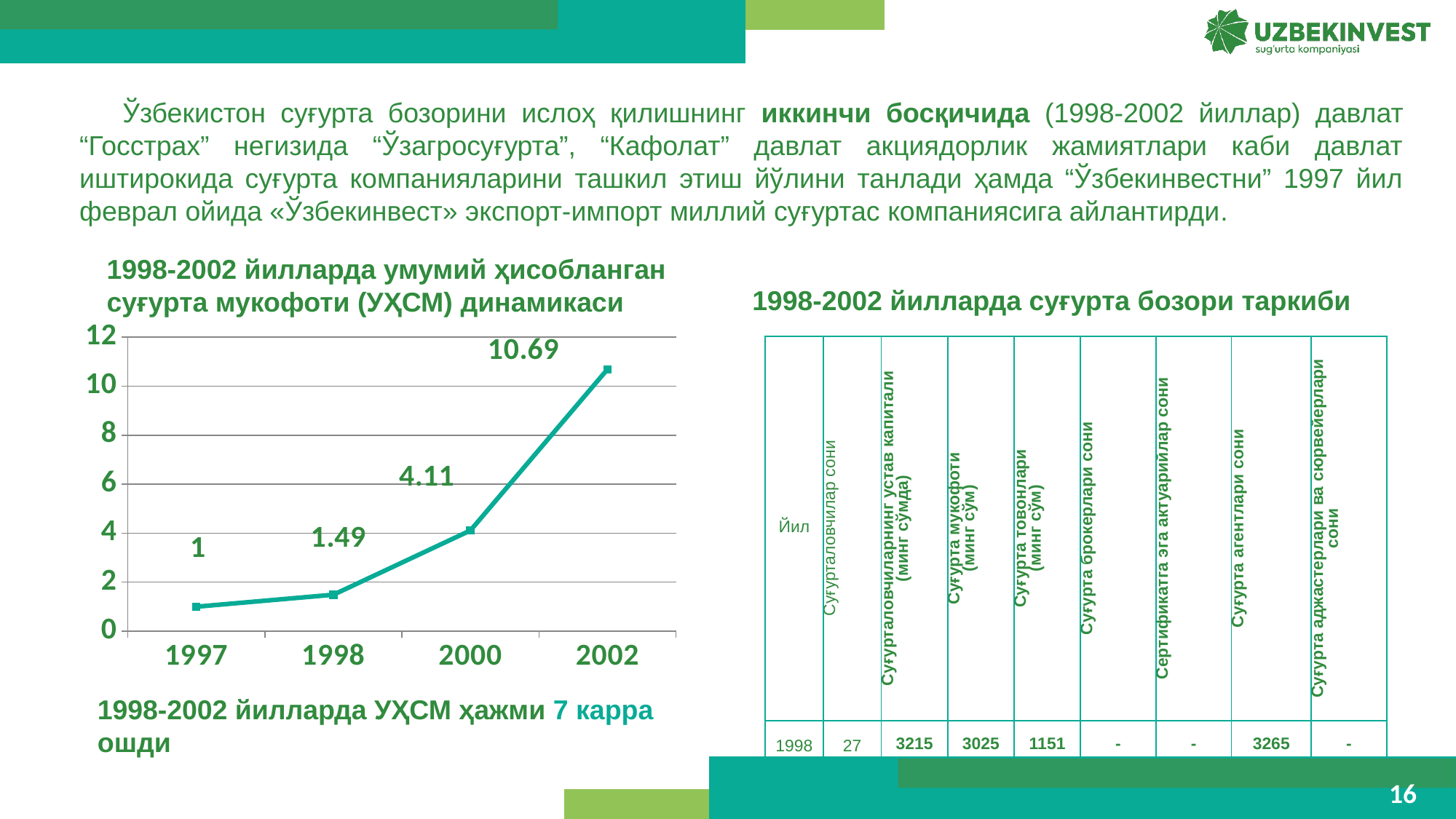
Which year has the lowest value on the chart? 1997 What is the difference between the values for 2002 and 2000? 6.58 Which year has the highest value on the chart? 2002 What type of chart is shown on the slide? line chart How many data points are plotted on the chart? 4 What is the maximum value shown on the chart's vertical axis? 12 Which is larger, the value for 1998 or the value for 2000? 2000 What is the value plotted for 2000? 4.11 Do the values rise or fall from 1997 to 2002? rise What is the value plotted for 2002? 10.69 What is the value plotted for 1998? 1.49 What is the value plotted for 1997? 1